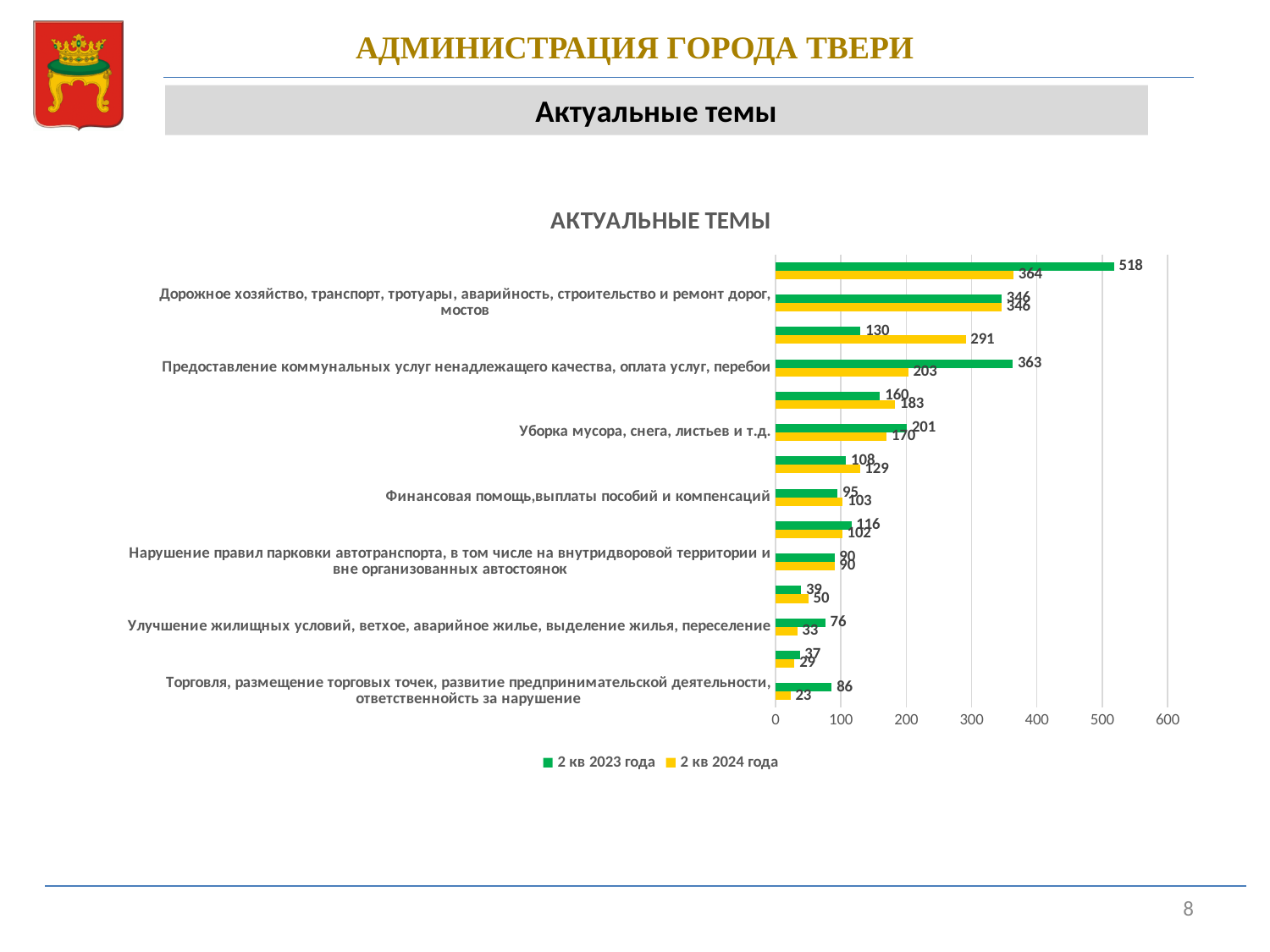
What is the value for 2 кв 2023 года for "Улучшение жилищных условий, ветхое, аварийное жилье, выделение жилья, переселение"? 76 What is the value for 2 кв 2024 года for "Предоставление коммунальных услуг ненадлежащего качества, оплата услуг, перебои"? 203 What are the two series named in the legend? 2 кв 2023 года and 2 кв 2024 года What is the difference between the 2 кв 2023 года and 2 кв 2024 года values for "Торговля, размещение торговых точек, развитие предпринимательской деятельности, ответственнойсть за нарушение"? 63 What is the value for 2 кв 2023 года for "Уборка мусора, снега, листьев и т.д."? 201 What is the value for 2 кв 2023 года for "Предоставление коммунальных услуг ненадлежащего качества, оплата услуг, перебои"? 363 What is the difference between the 2 кв 2023 года and 2 кв 2024 года values for "Предоставление коммунальных услуг ненадлежащего качества, оплата услуг, перебои"? 160 Which series has the larger value for "Финансовая помощь,выплаты пособий и компенсаций"? 2 кв 2024 года How many series does the legend list? 2 What kind of chart is shown on the slide? bar chart What is the value for 2 кв 2024 года for "Торговля, размещение торговых точек, развитие предпринимательской деятельности, ответственнойсть за нарушение"? 23 Is the 2 кв 2023 года value for "Дорожное хозяйство, транспорт, тротуары, аварийность, строительство и ремонт дорог, мостов" greater or less than 300? greater